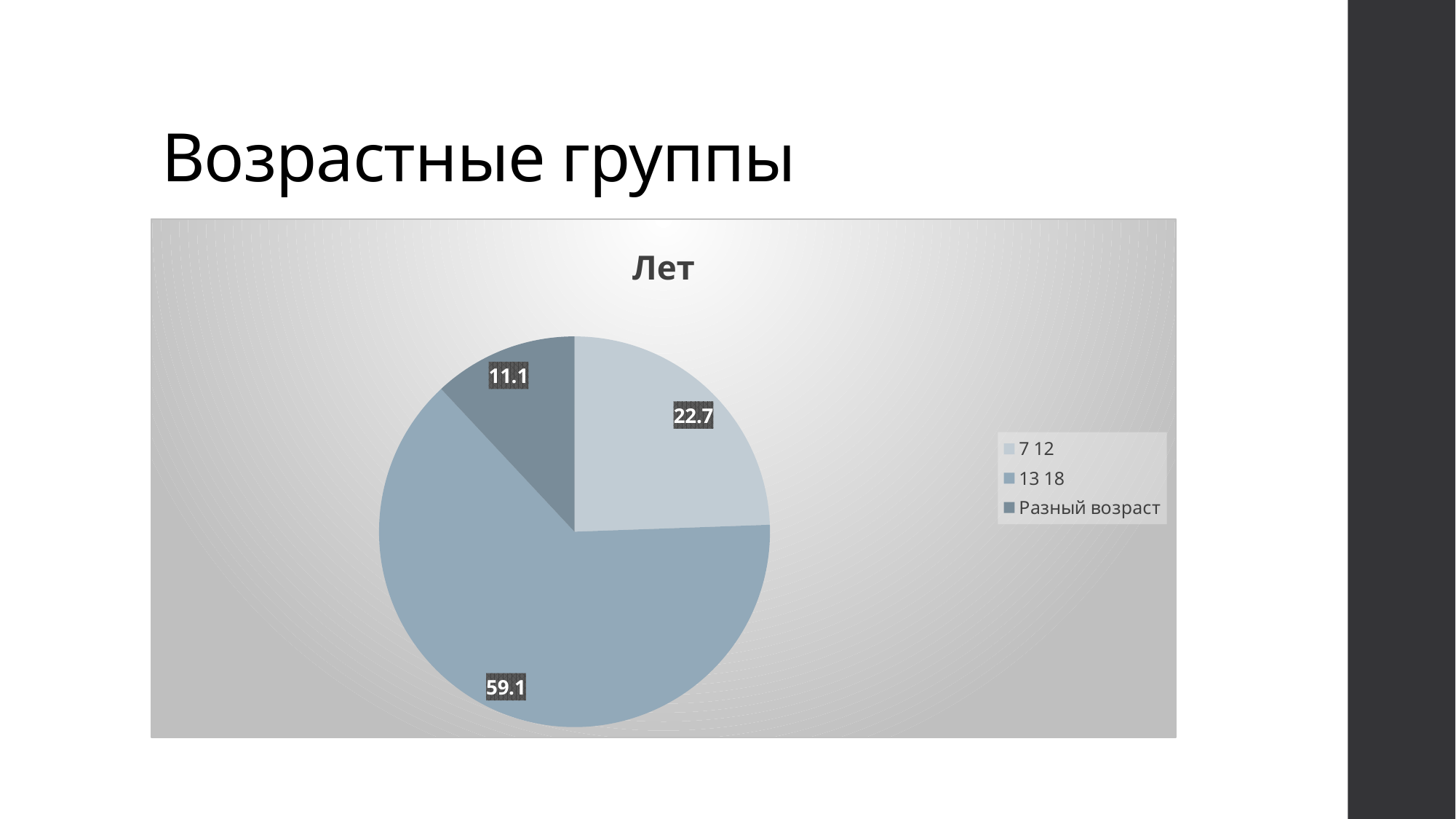
How many slices does the pie chart have? 3 Which is larger, the value for 7 12 or the value for Разный возраст? 7 12 What is the difference between the values for 13 18 and 7 12? 36.4 What is the title of the chart? Лет Which category has the smallest slice? Разный возраст Which category has the largest slice? 13 18 What kind of chart is shown on the slide? pie chart What is the value for the 13 18 slice? 59.1 What is the value for the Разный возраст slice? 11.1 What is the difference between the values for 7 12 and Разный возраст? 11.6 What is the value for the 7 12 slice? 22.7 How many entries does the legend list? 3